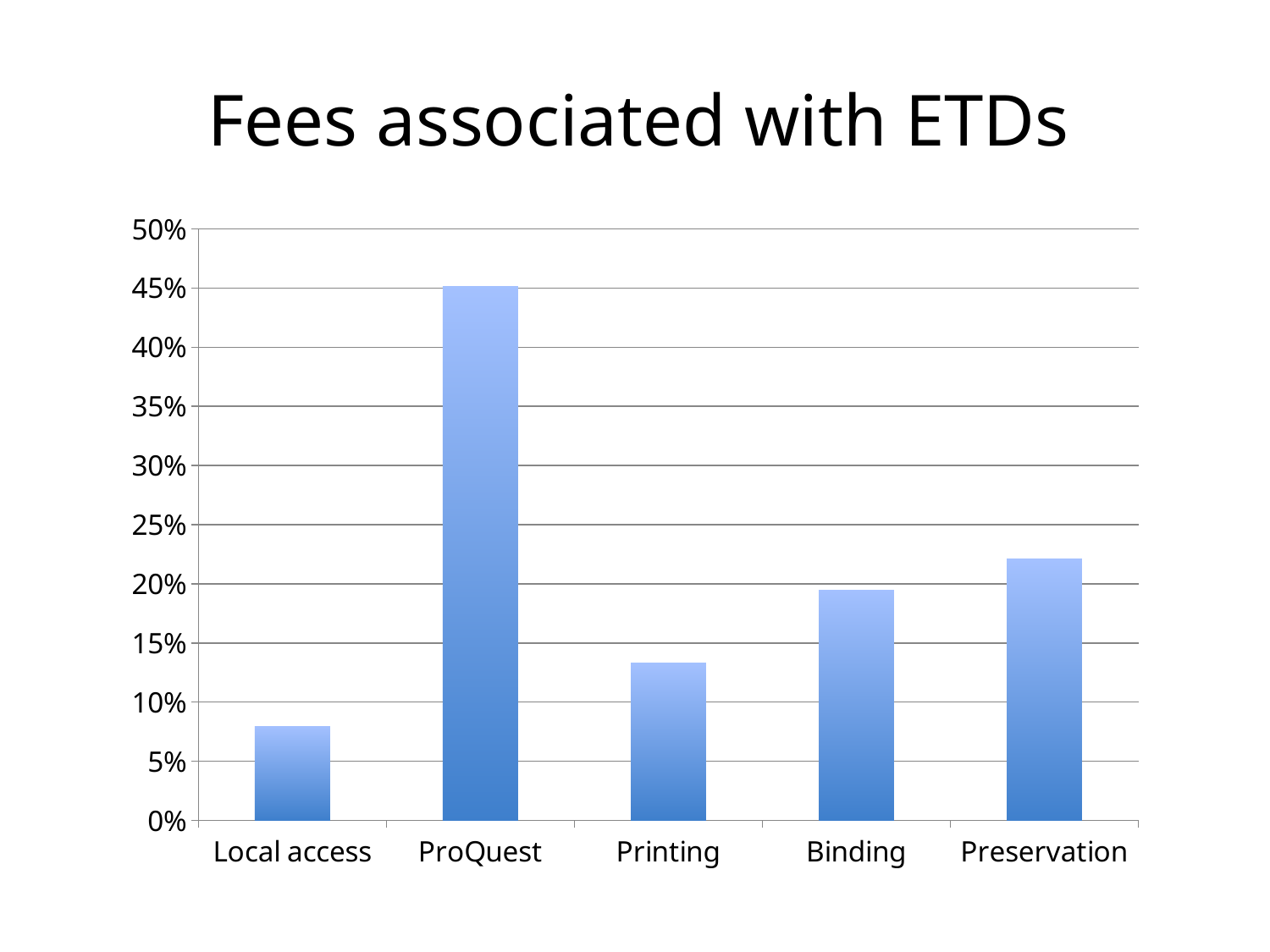
What kind of chart is shown on the slide? bar chart Is the value for ProQuest greater or less than 40%? greater What is the title of the chart? Fees associated with ETDs Which is larger, the value for Preservation or the value for Binding? Preservation Which category has the highest value? ProQuest How many categories are shown on the x axis? 5 Is the value for Binding greater or less than 15%? greater Is the value for Local access greater or less than 10%? less Which is larger, the value for Printing or the value for Local access? Printing Which category has the lowest value? Local access